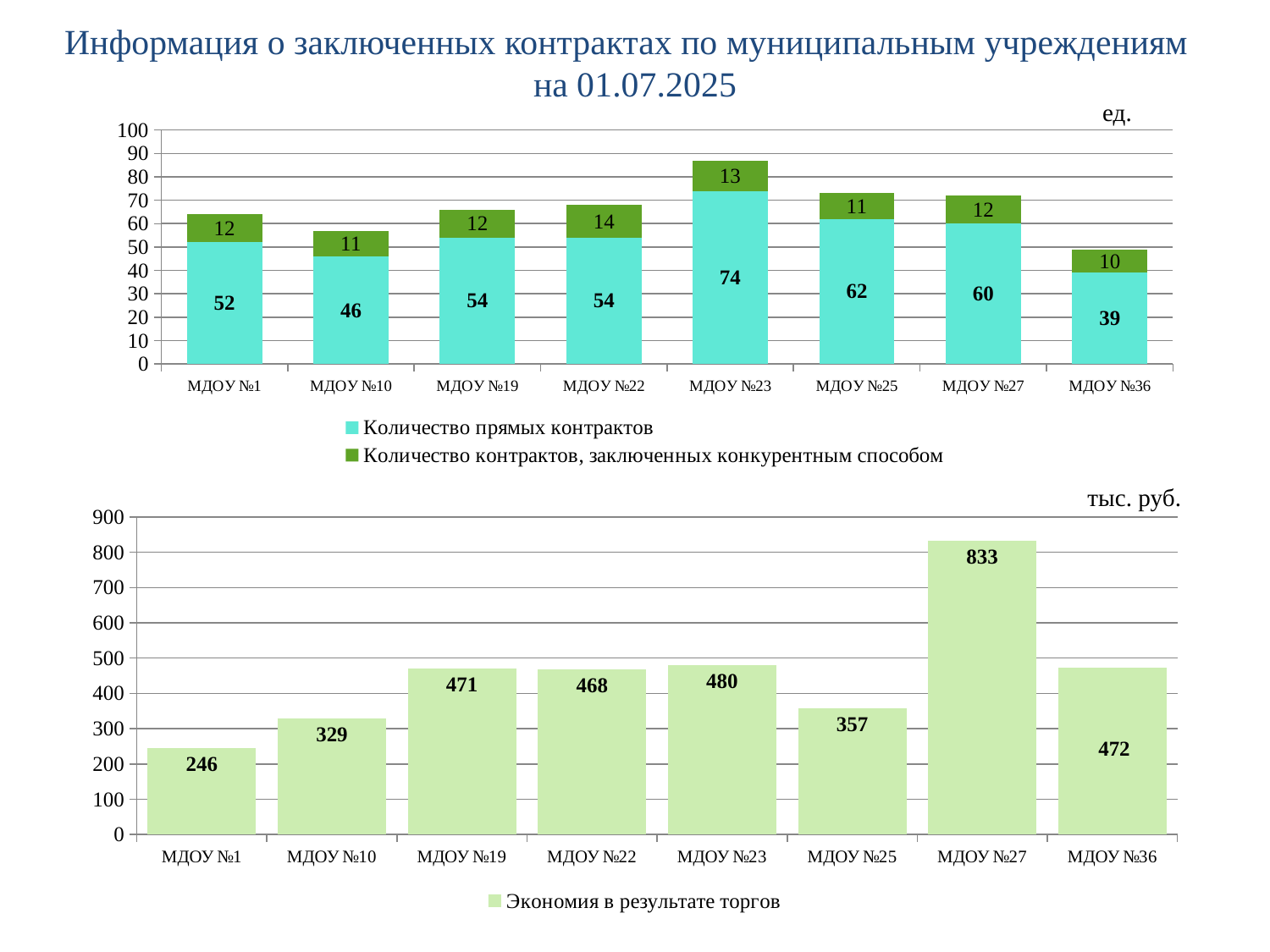
In the top chart, which institution has the lowest number of direct contracts? МДОУ №36 In the top chart, what is the difference between the direct contracts of МДОУ №25 and МДОУ №10? 16 In the bottom chart, which institution has the lowest savings value? МДОУ №1 In the bottom chart, which is larger: the value for МДОУ №25 or the value for МДОУ №36? МДОУ №36 What unit is indicated above the bottom chart? тыс. руб. How many series does the legend of the top chart list? 2 In the bottom chart, what is the difference between the values for МДОУ №27 and МДОУ №1? 587 In the top chart, how many contracts concluded by competitive method does МДОУ №22 have? 14 In the top chart, how many direct contracts (Количество прямых контрактов) does МДОУ №23 have? 74 In the bottom chart, what is the savings value (Экономия в результате торгов) for МДОУ №27? 833 How many institutions are shown on the x axis of the bottom chart? 8 In the top chart, what is the total height of the stacked bar for МДОУ №23? 87